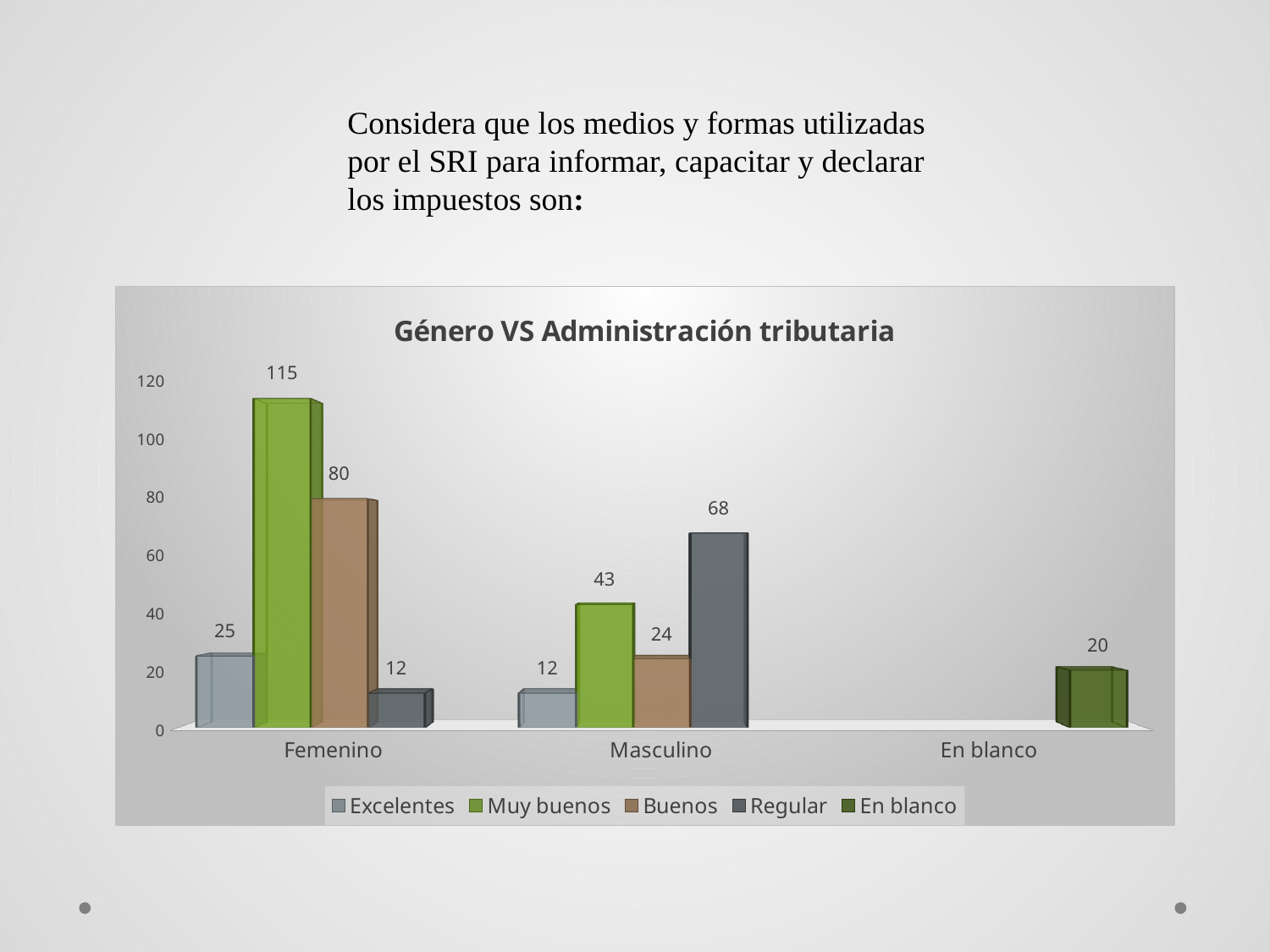
What is the value for Muy buenos in the Femenino category? 115 How many categories are shown on the x axis? 3 What is the value for the En blanco series in the En blanco category? 20 How many series does the legend list? 5 Which series has the highest value in the Femenino category? Muy buenos Which series has the lowest value in the Masculino category? Excelentes What is the value for Regular in the Masculino category? 68 What is the difference between the Buenos values for Femenino and Masculino? 56 What kind of chart is shown? Bar chart What is the value for Excelentes in the Femenino category? 25 What is the title of the chart? Género VS Administración tributaria Which is larger: Muy buenos for Masculino or Regular for Masculino? Regular for Masculino